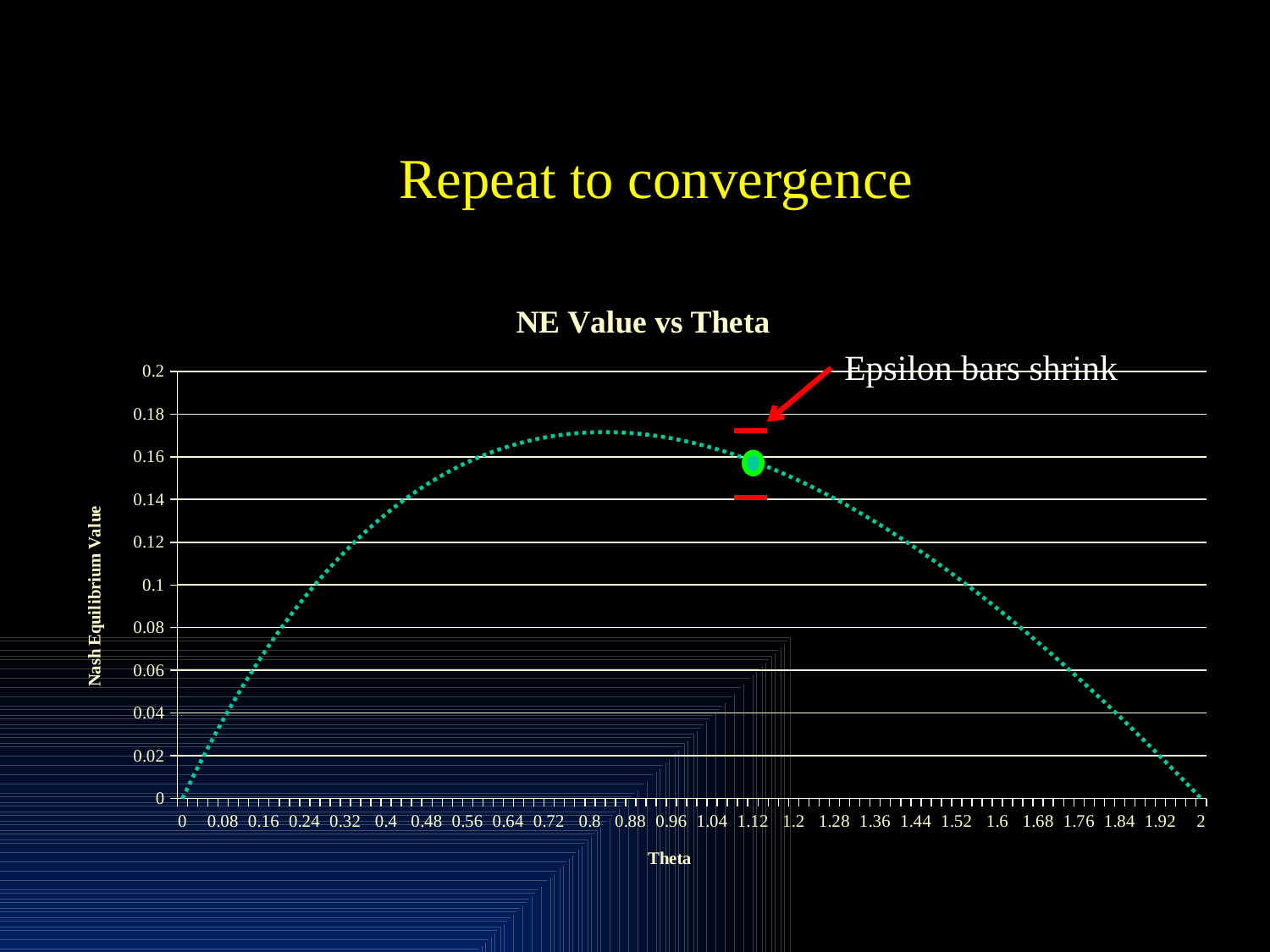
What is the Nash Equilibrium Value at Theta = 2? 0 What is the label of the vertical axis? Nash Equilibrium Value Is the value at Theta = 1.76 greater or less than 0.08? less Do the values rise or fall as Theta increases from 1.2 to 2? fall Is the value at Theta = 0.48 greater or less than 0.12? greater What is the Nash Equilibrium Value at Theta = 0? 0 What kind of chart is shown on the slide? line chart Is the value at Theta = 1.92 greater or less than 0.04? less Which has the larger Nash Equilibrium Value, Theta = 0.8 or Theta = 1.6? Theta = 0.8 Do the values rise or fall as Theta increases from 0 to 0.56? rise What is the title of the chart? NE Value vs Theta